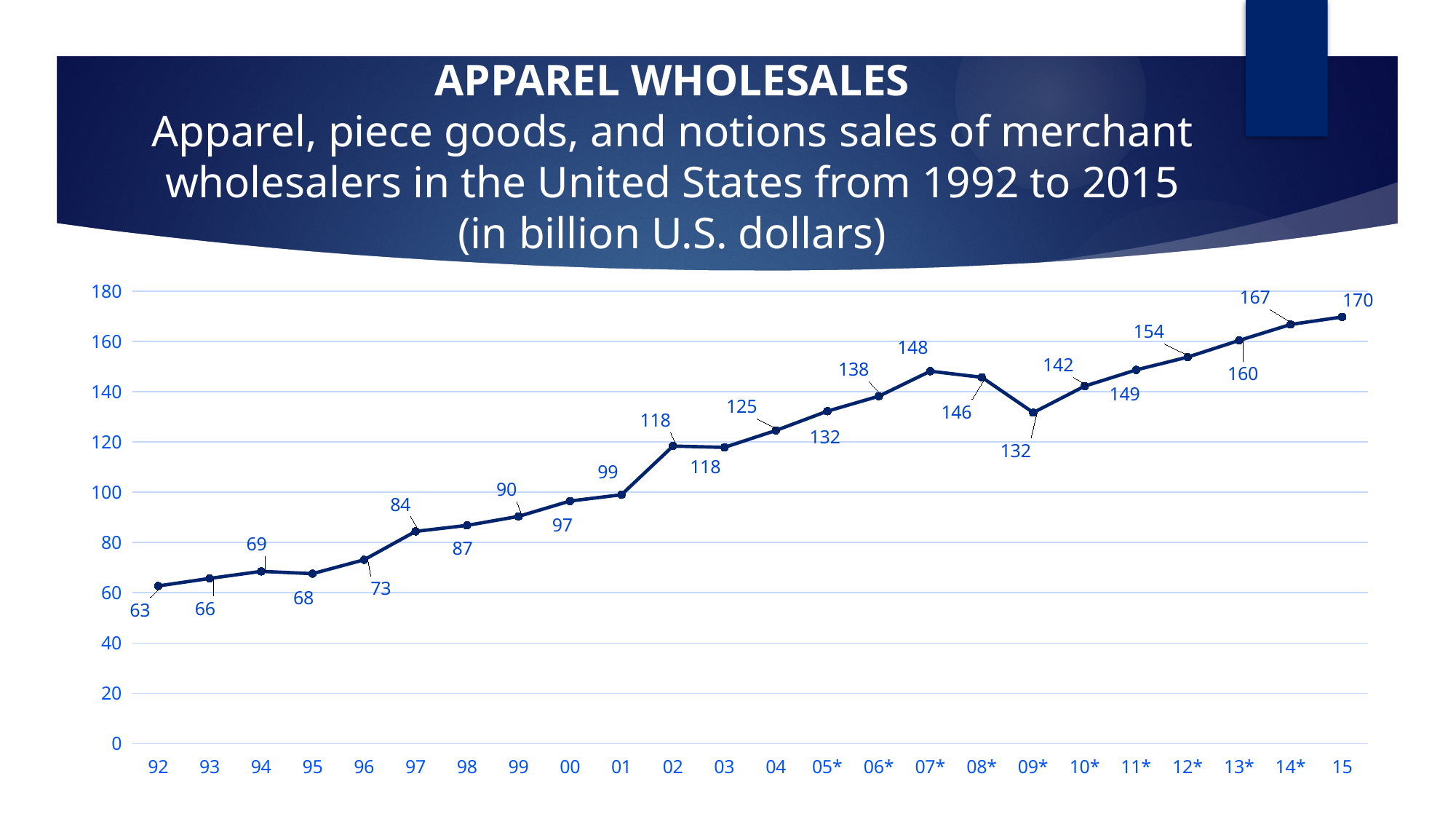
How many data points are plotted on the chart? 24 What is the value for 92? 63 What kind of chart is shown on the slide? line chart What unit are the values on the chart expressed in, according to the title? billion U.S. dollars Which is larger, the value for 07* or the value for 08*? 07* What is the difference between the values for 07* and 09*? 16 What is the value for 07*? 148 What is the difference between the values for 15 and 92? 107 Do the values generally rise or fall from 92 to 15? rise What is the value for 09*? 132 Which year has the lowest value? 92 Which year has the highest value? 15